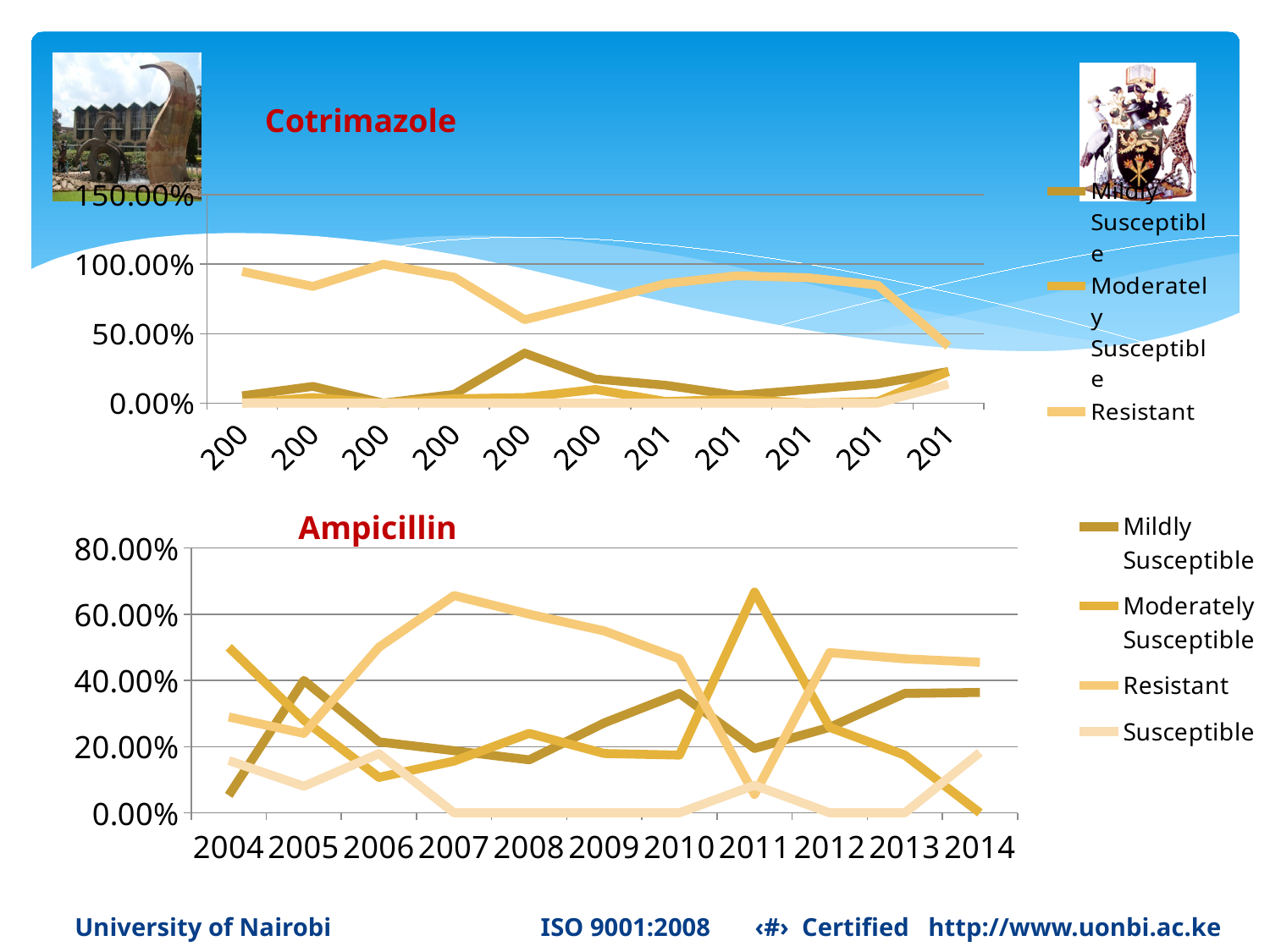
In the Ampicillin chart, which year has the highest Resistant value? 2007 In the Ampicillin chart, is the Susceptible value for 2007 greater or less than 20.00%? less In the Ampicillin chart, does the Resistant series rise or fall from 2007 to 2011? fall In the Ampicillin chart, is the Mildly Susceptible value for 2004 greater or less than 20.00%? less How many years are shown on the x axis of the Ampicillin chart? 11 In the Ampicillin chart, is the Moderately Susceptible value for 2011 greater or less than 60.00%? greater What is the highest value shown on the y axis of the Cotrimazole chart? 150.00% What kind of chart is the Ampicillin chart? line chart In the Ampicillin chart, which year has the highest Moderately Susceptible value? 2011 In the Ampicillin chart, which is larger in 2007: the Resistant value or the Mildly Susceptible value? Resistant How many series does the legend of the Ampicillin chart list? 4